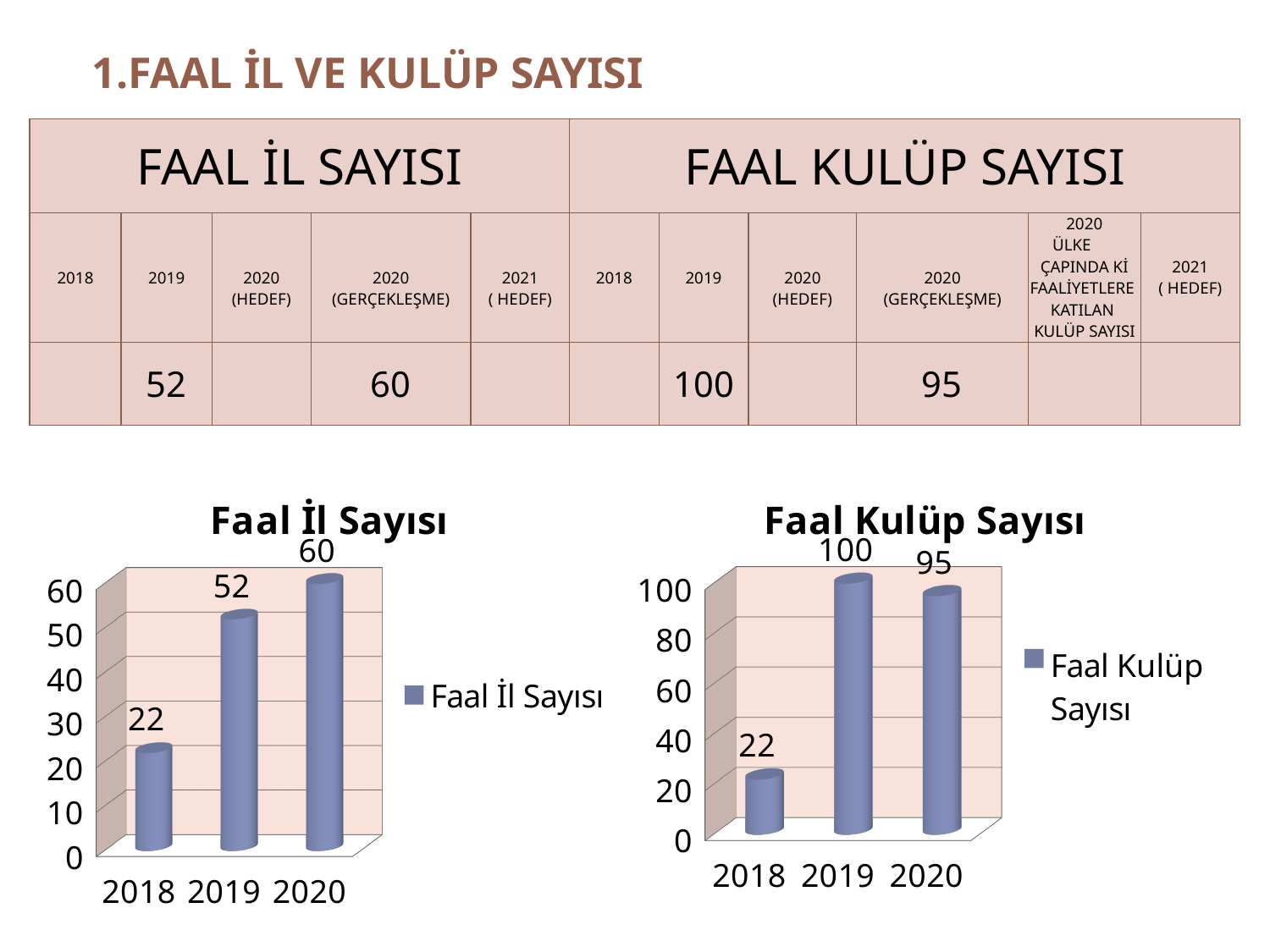
In the 'Faal İl Sayısı' chart, what is the value for 2019? 52 In the 'Faal İl Sayısı' chart, which year has the lowest value? 2018 In the 'Faal İl Sayısı' chart, do the values rise or fall from 2018 to 2020? Rise In the 'Faal Kulüp Sayısı' chart, what is the value for 2020? 95 In the 'Faal İl Sayısı' chart, what is the value for 2018? 22 How many years are shown on the x axis of the 'Faal İl Sayısı' chart? 3 In the 'Faal İl Sayısı' chart, what is the difference between the values for 2020 and 2019? 8 How many series does the legend of the 'Faal Kulüp Sayısı' chart list? 1 In the 'Faal Kulüp Sayısı' chart, which year has the highest value? 2019 In the 'Faal Kulüp Sayısı' chart, what is the difference between the values for 2019 and 2018? 78 In the 'Faal Kulüp Sayısı' chart, which is larger, the value for 2019 or the value for 2020? 2019 What kind of chart is the 'Faal İl Sayısı' chart? Bar chart